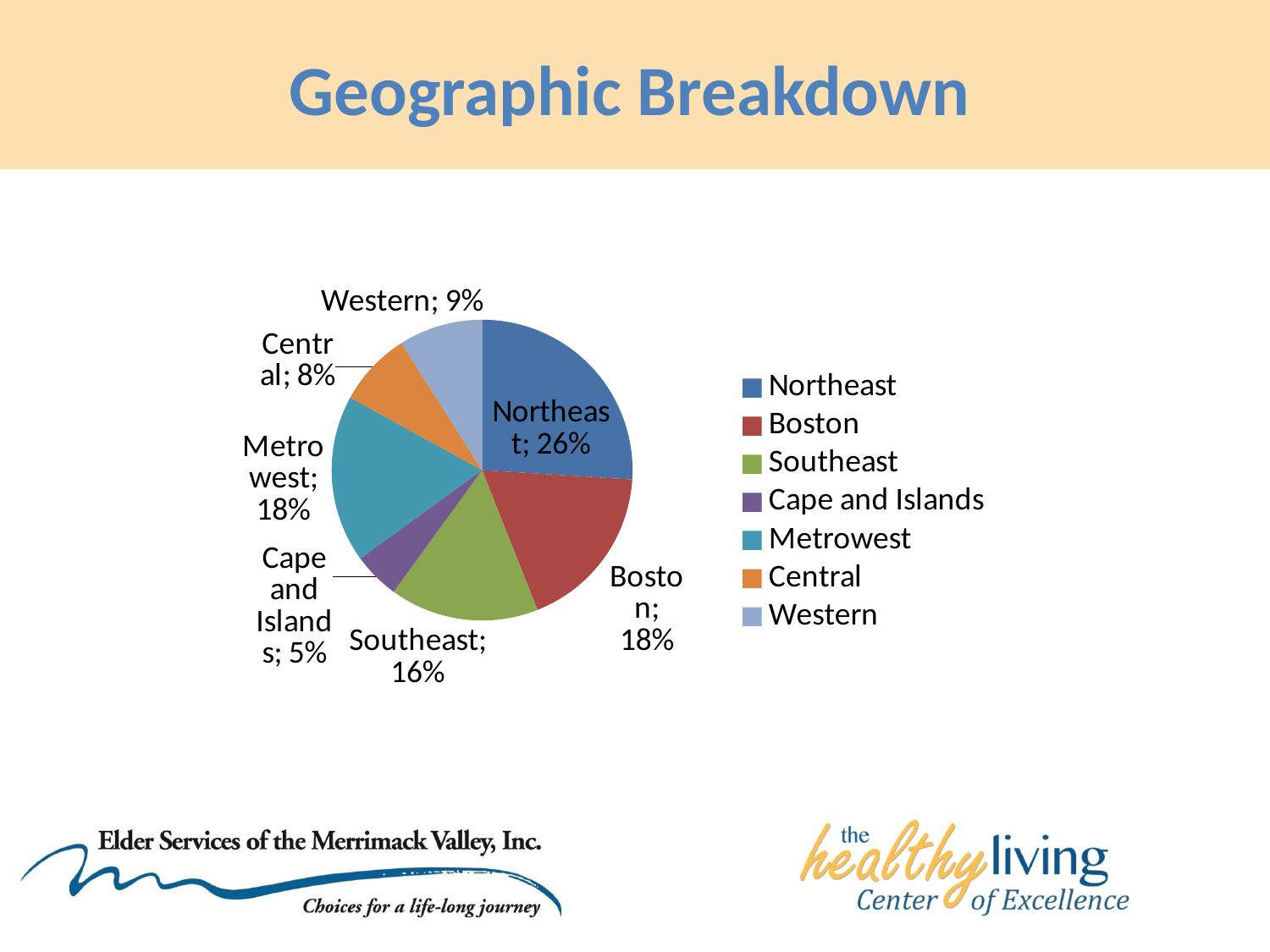
Which is larger, the Central slice or the Western slice? Western Which region has the smallest slice of the pie? Cape and Islands What percentage is shown for Southeast? 16% What percentage is shown for Cape and Islands? 5% What share of the pie does Northeast represent? 26% What percentage is shown for Metrowest? 18% Which legend entry is shown in orange? Central What kind of chart is shown on the slide? pie chart How many regions are shown in the pie chart? 7 Which region has the largest slice of the pie? Northeast What is the title of the slide containing the chart? Geographic Breakdown What is the difference in percentage points between Northeast and Western? 17